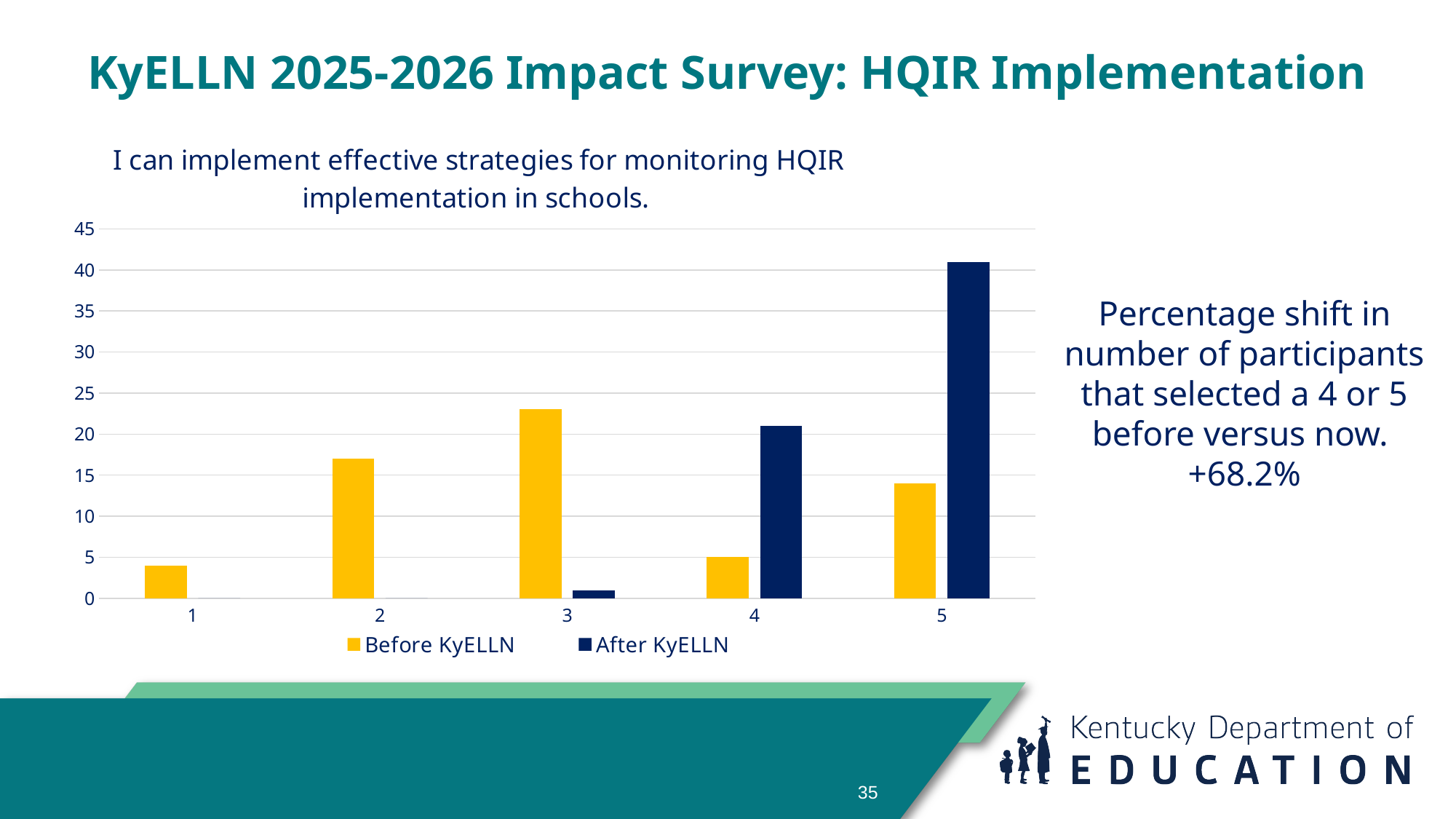
How many rating categories are shown on the x axis? 5 Which rating category has the highest value for the After KyELLN series? 5 What percentage shift in participants selecting a 4 or 5 is stated on the slide? +68.2% What kind of chart is shown on the slide? bar chart Is the Before KyELLN value for rating 3 greater or less than 20? greater How many series does the legend list? 2 Is the After KyELLN value for rating 5 greater or less than 35? greater Which rating category has the highest value for the Before KyELLN series? 3 Is the Before KyELLN value for rating 1 greater or less than 10? less For rating 5, which series has the larger value, Before KyELLN or After KyELLN? After KyELLN Which rating category has the lowest value for the Before KyELLN series? 1 For rating 3, which series has the larger value, Before KyELLN or After KyELLN? Before KyELLN